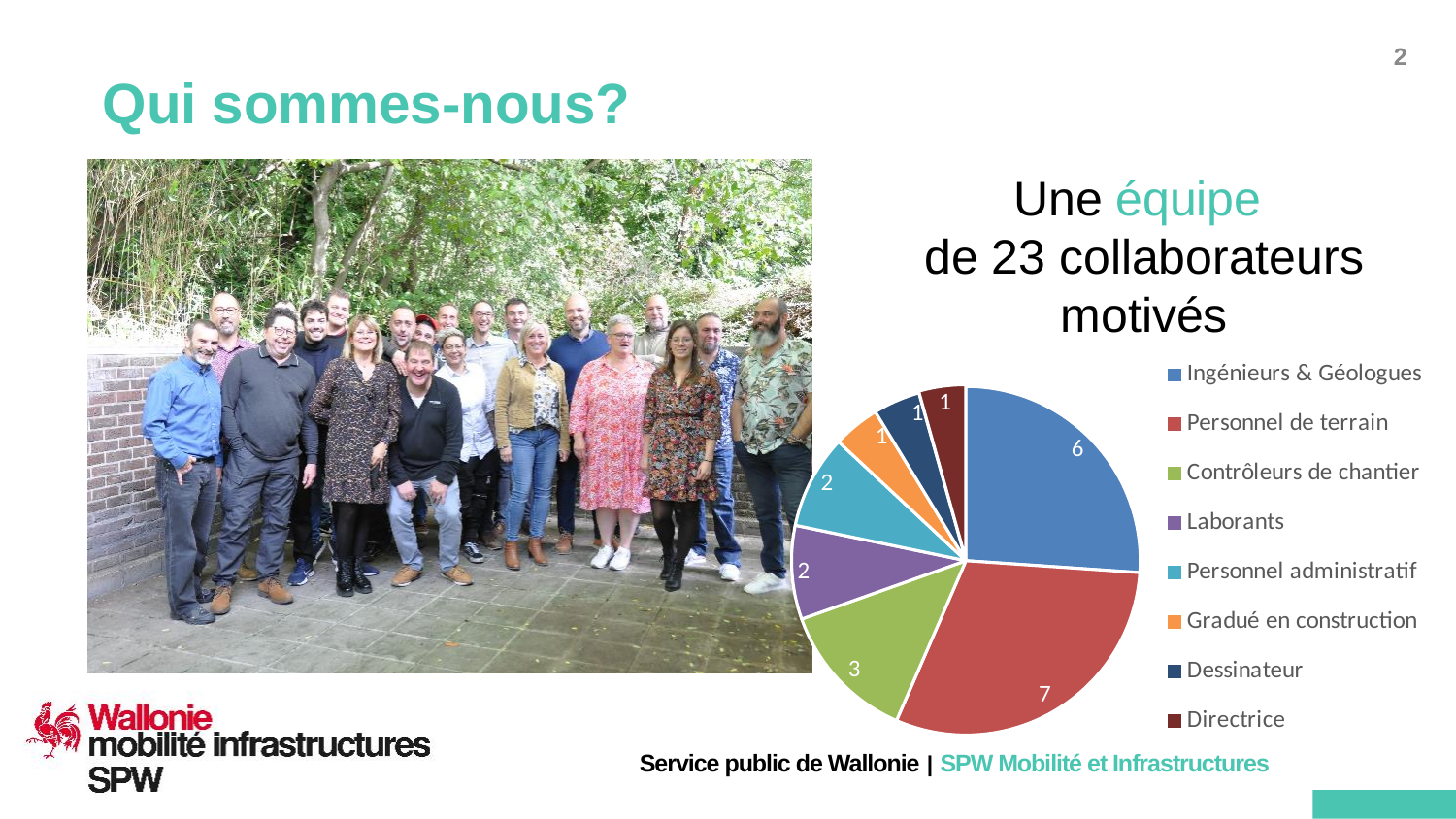
What is the total of all slices in the pie chart? 23 What is the difference between the values for Personnel de terrain and Ingénieurs & Géologues? 1 What is the value for Laborants in the pie chart? 2 What is the value for Personnel de terrain in the pie chart? 7 Which legend entry is listed last in the pie chart's legend? Directrice How many slices does the pie chart have? 8 What kind of chart is shown on the slide? pie chart What is the difference between the values for Ingénieurs & Géologues and Contrôleurs de chantier? 3 Which category has the largest slice in the pie chart? Personnel de terrain Which is larger, the value for Contrôleurs de chantier or the value for Personnel administratif? Contrôleurs de chantier What is the value for Ingénieurs & Géologues in the pie chart? 6 What is the value for Contrôleurs de chantier in the pie chart? 3